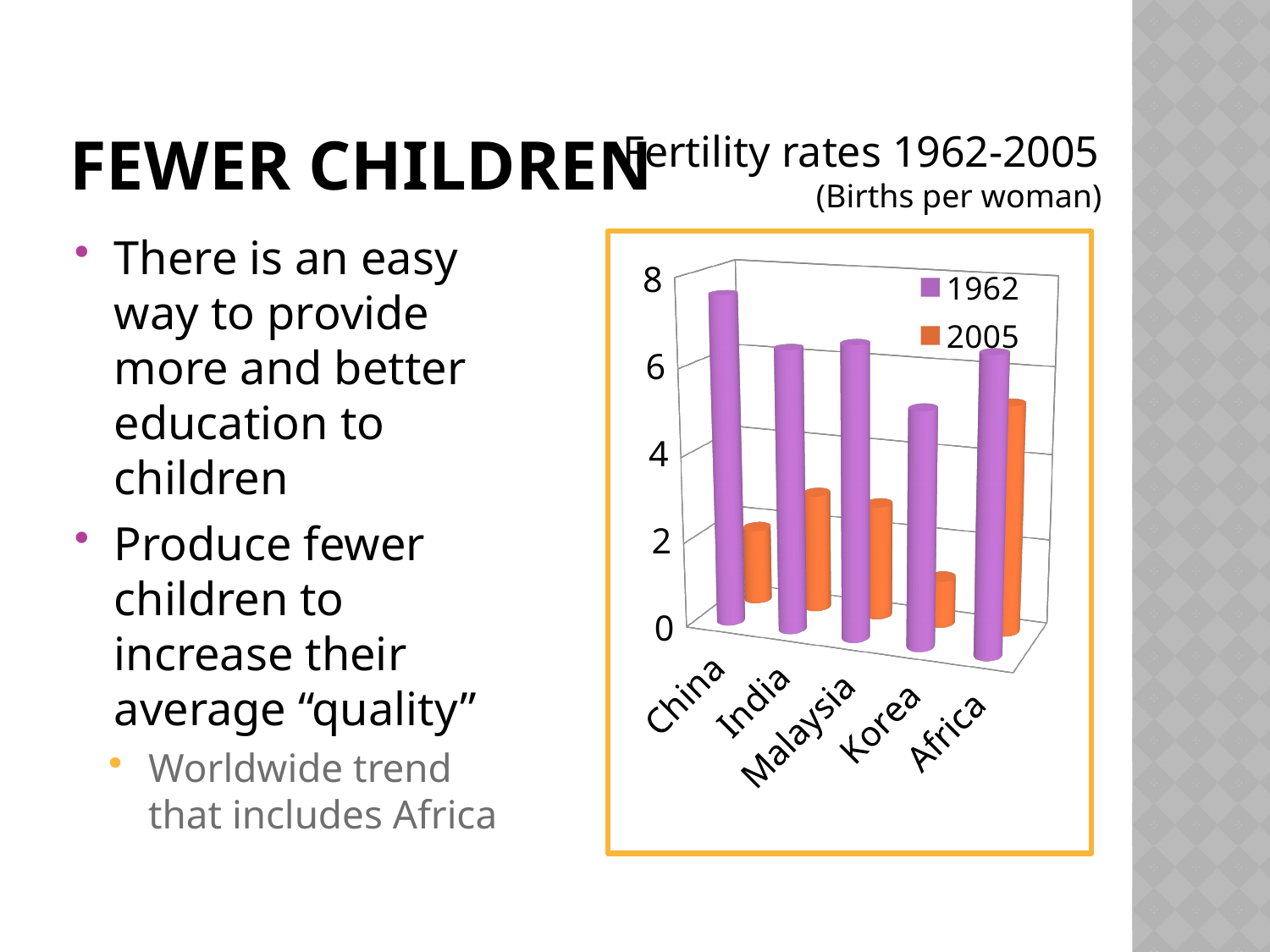
How many series does the chart legend list? 2 Which country or region has the highest fertility rate for 2005? Africa What is the title of the chart? Fertility rates 1962-2005 For each country, is the 2005 fertility rate higher or lower than the 1962 rate? lower Is the 1962 value for China greater or less than 6? greater Which is larger, the 2005 value for India or the 2005 value for Korea? India Which country or region has the lowest fertility rate for 2005? Korea Is the 2005 value for Korea greater or less than 2? less Which country or region has the highest fertility rate for 1962? China How many countries or regions are shown on the x axis of the chart? 5 What kind of chart is shown on the slide? bar chart Is the 2005 value for Africa greater or less than 4? greater